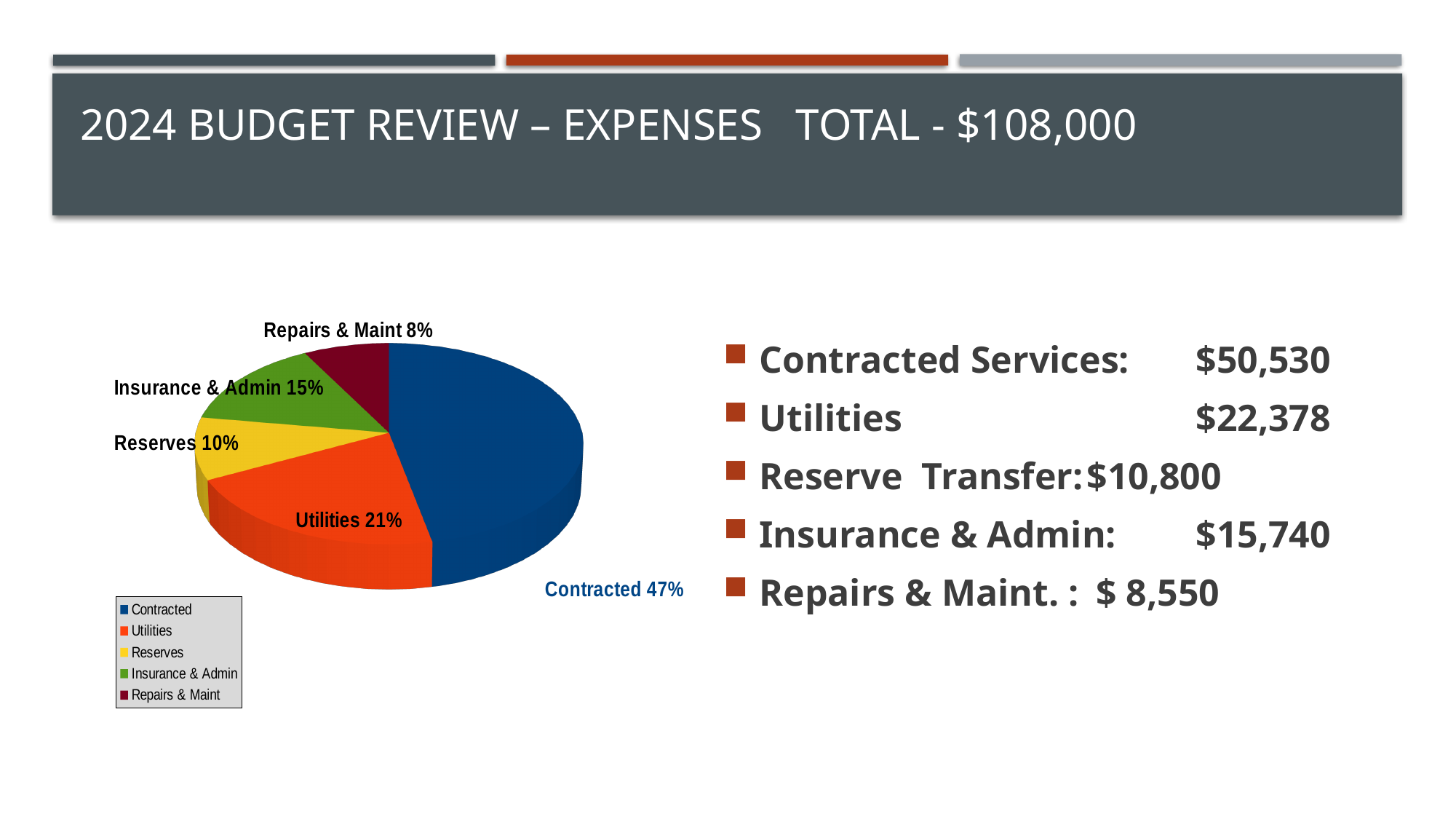
How many slices does the pie chart have? 5 Which category has the largest slice in the pie chart? Contracted Which slice is larger, Insurance & Admin or Reserves? Insurance & Admin What percentage share does the Utilities slice have in the pie chart? 21% What percentage share does the Repairs & Maint slice have in the pie chart? 8% Which category has the smallest slice in the pie chart? Repairs & Maint What is the difference in percentage points between the Contracted and Utilities slices? 26 What percentage share does the Insurance & Admin slice have in the pie chart? 15% What kind of chart is shown on the slide? pie chart What colour is the Contracted slice in the pie chart? blue